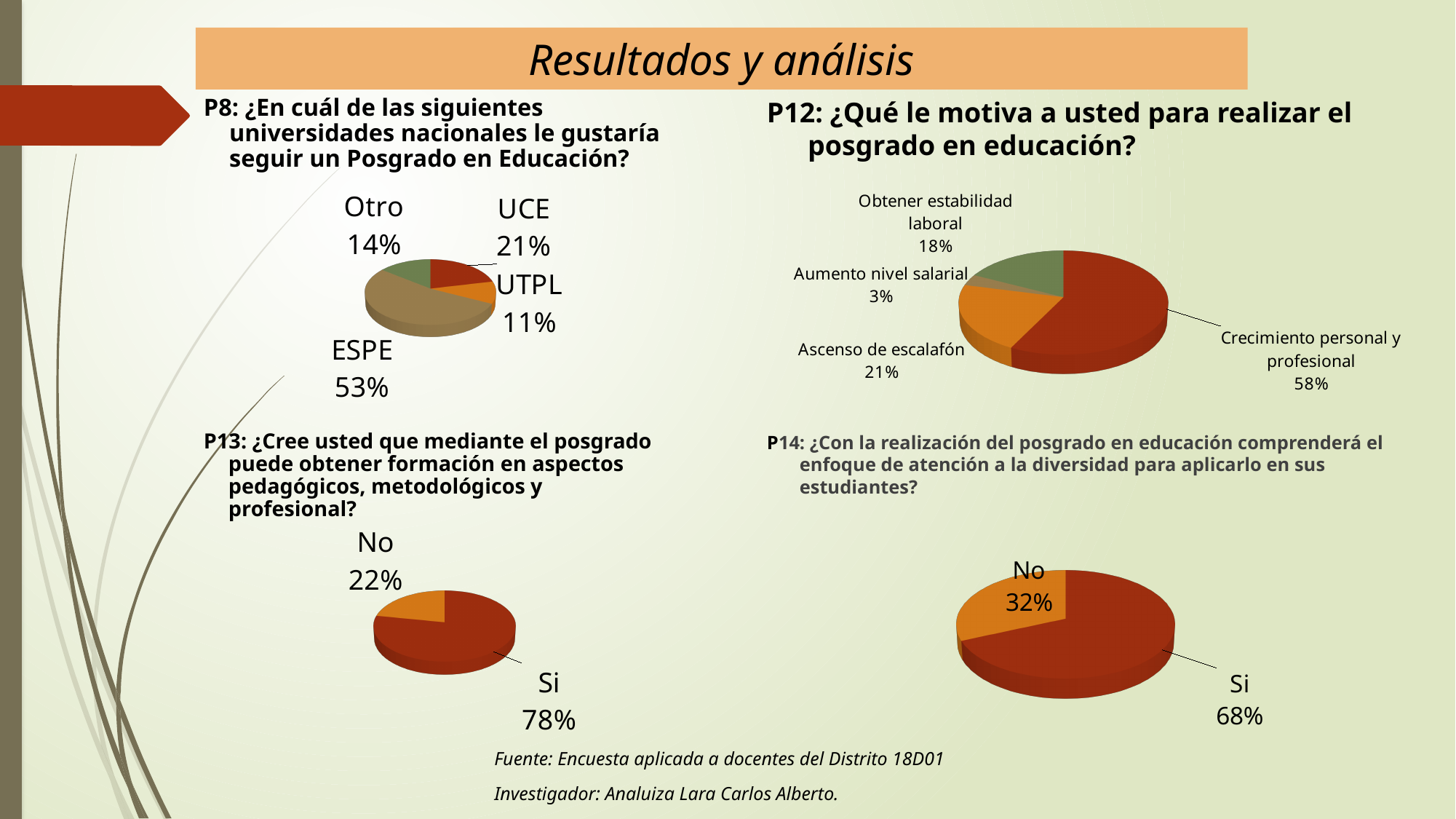
In the P14 pie chart (bottom right), what share answered 'Si'? 68% In the P8 pie chart (top left), what share of respondents chose ESPE? 53% In the P8 pie chart (top left), what is the difference between the shares for UCE and UTPL? 10% In the P8 pie chart (top left), which university has the smallest share? UTPL In the P12 pie chart (top right), how many categories are shown? 4 In the P12 pie chart (top right), what share is labelled 'Crecimiento personal y profesional'? 58% In the P14 pie chart (bottom right), what is the difference between the 'Si' and 'No' shares? 36% What type of chart is used for P13 (bottom left)? Pie chart In the P12 pie chart (top right), which category has the lowest share? Aumento nivel salarial In the P13 pie chart (bottom left), what share answered 'No'? 22% In the P12 pie chart (top right), which is larger: 'Obtener estabilidad laboral' or 'Ascenso de escalafón'? Ascenso de escalafón In the P8 pie chart (top left), how many slices does the pie have? 4